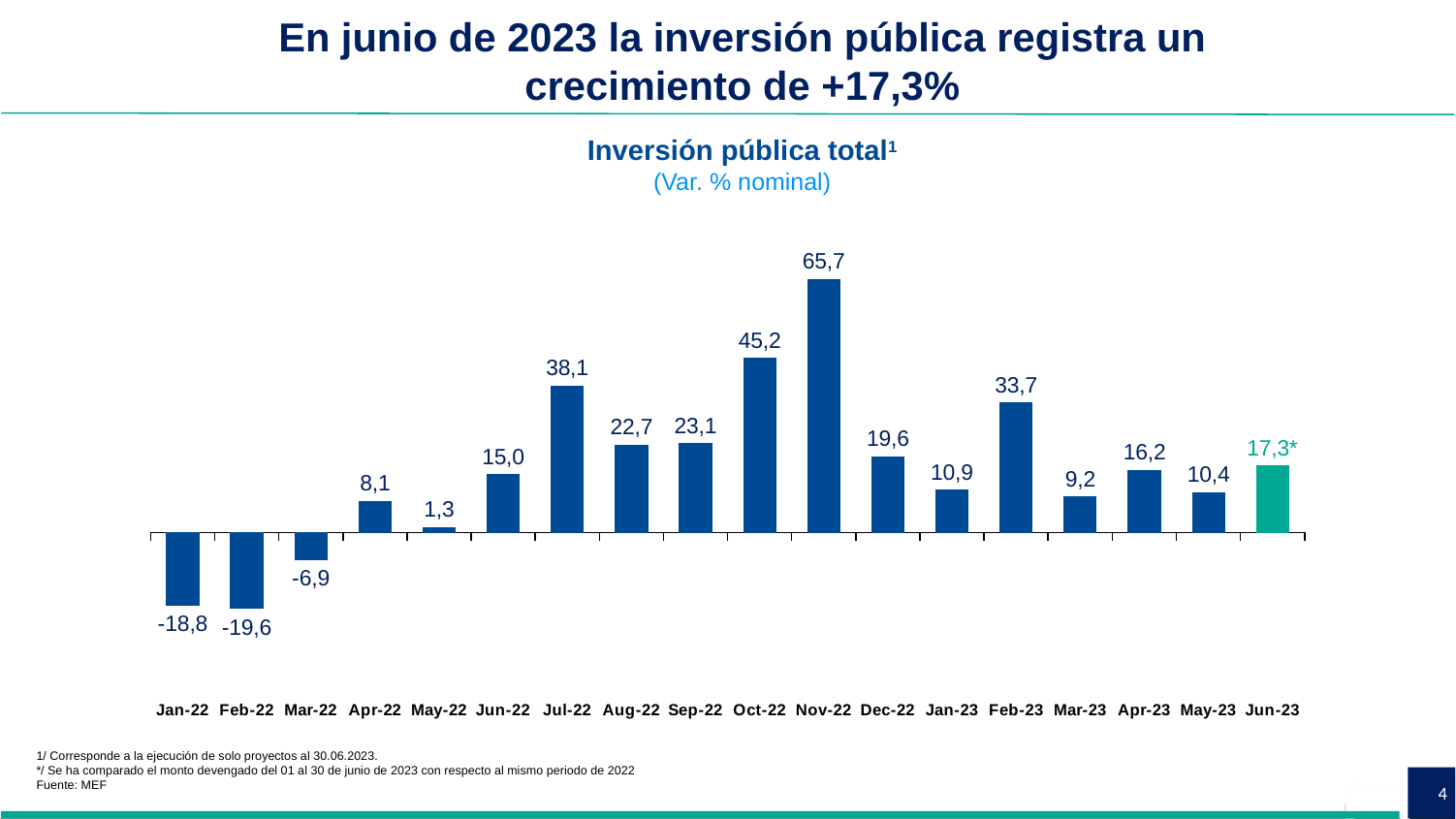
What is the value for Jun-23? 17,3* What is the title of the chart? Inversión pública total How many months are plotted on the chart? 18 What is the difference between the values for Jun-23 and May-23? 6,9 What is the value for Feb-22? -19,6 What is the value for Nov-22? 65,7 Which is larger, the value for Feb-23 or the value for Dec-22? Feb-23 Which month has the highest value? Nov-22 What kind of chart is shown? Bar chart What is the difference between the values for Nov-22 and Oct-22? 20,5 Which month has the lowest value? Feb-22 How many months have a negative value? 3